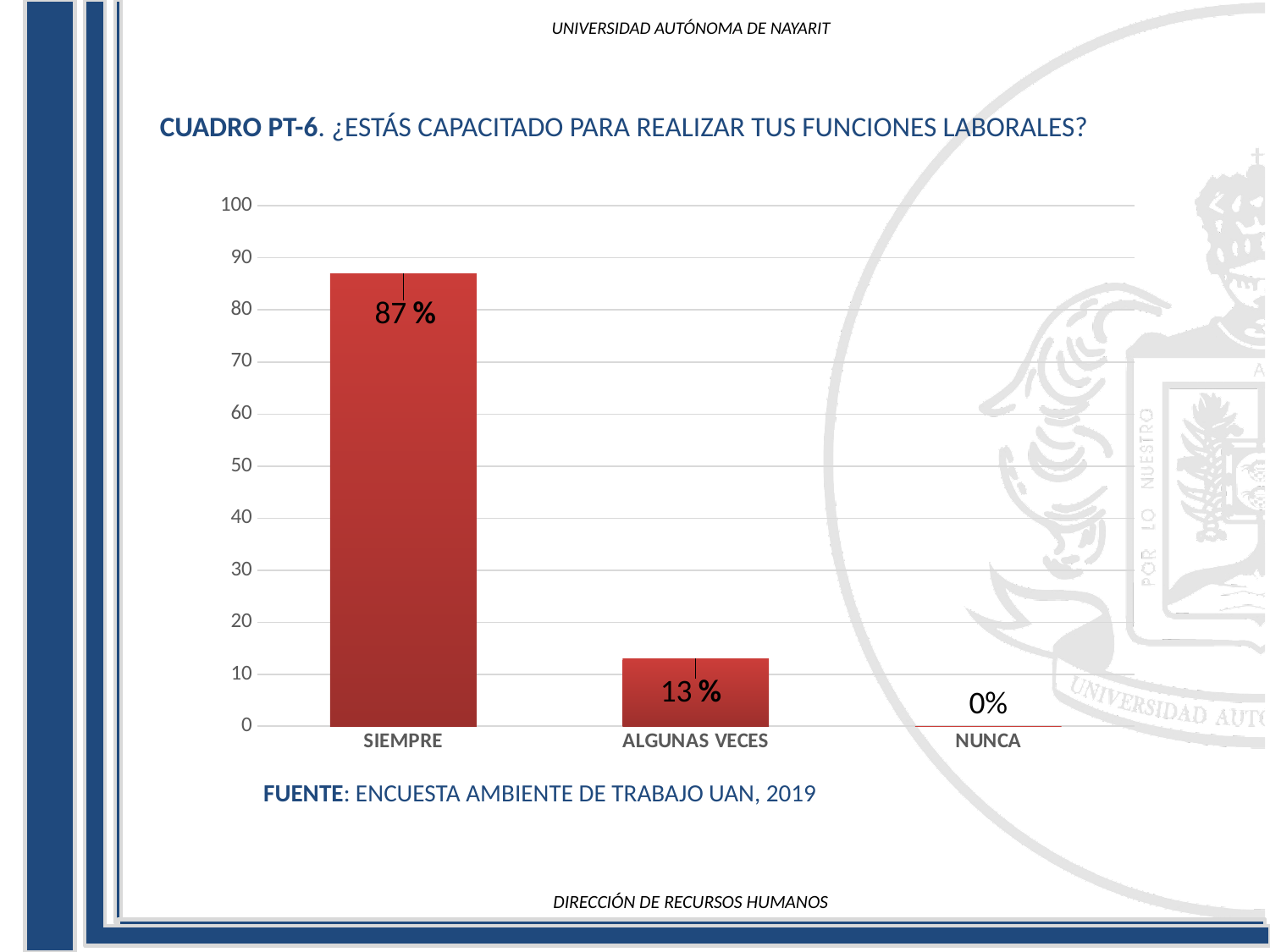
What kind of chart is shown on the slide? bar chart What is the value for NUNCA? 0% What is the value for SIEMPRE? 87% Which is larger, the value for ALGUNAS VECES or the value for NUNCA? ALGUNAS VECES Which category has the lowest value? NUNCA What is the difference between the values for SIEMPRE and ALGUNAS VECES? 74% What is the value for ALGUNAS VECES? 13% Which category has the highest value? SIEMPRE What source is cited below the chart? ENCUESTA AMBIENTE DE TRABAJO UAN, 2019 Do the values rise or fall from left to right along the x axis? fall Is the value for SIEMPRE greater or less than 80? greater How many categories are shown on the x axis? 3